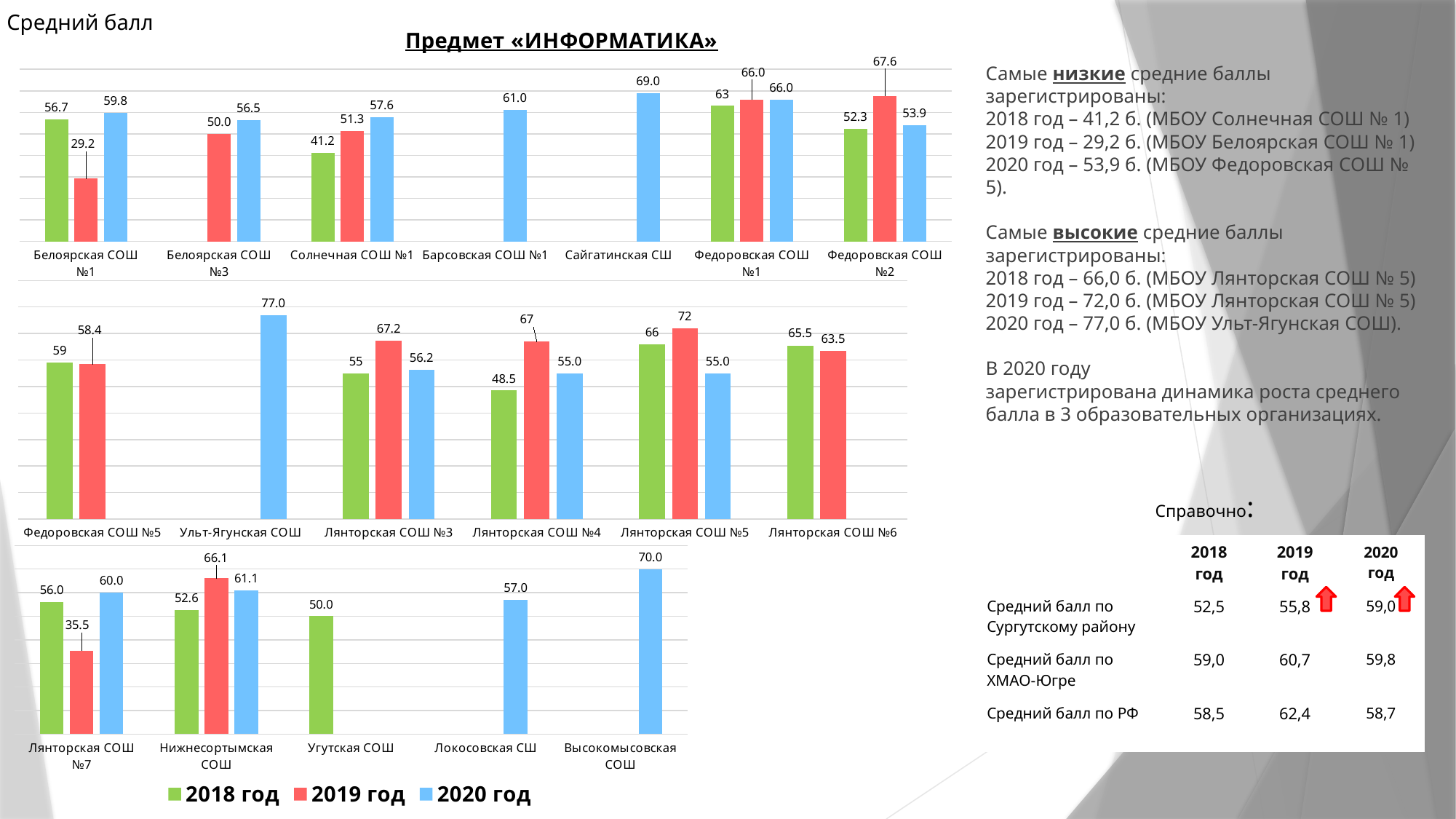
In the middle chart, which is larger: the 2019 год value for Лянторская СОШ №5 or for Лянторская СОШ №4? Лянторская СОШ №5 In the top chart, what is the difference between the 2019 год and 2020 год values for Федоровская СОШ №2? 13.7 In the top chart, what is the value for Белоярская СОШ №1 in 2019 год? 29.2 How many schools are shown in the bottom chart? 5 In the middle chart, what is the value for Лянторская СОШ №3 in 2018 год? 55 How many series does the legend list? 3 In the middle chart, which school has the highest value? Ульт-Ягунская СОШ What kind of chart is shown on the slide? bar chart In the top chart, which bar has the lowest value? Белоярская СОШ №1, 2019 год In the bottom chart, what is the value for Высокомысовская СОШ in 2020 год? 70.0 In the top chart, do the values for Солнечная СОШ №1 rise or fall from 2018 год to 2020 год? rise What colour represents 2020 год in the legend? blue